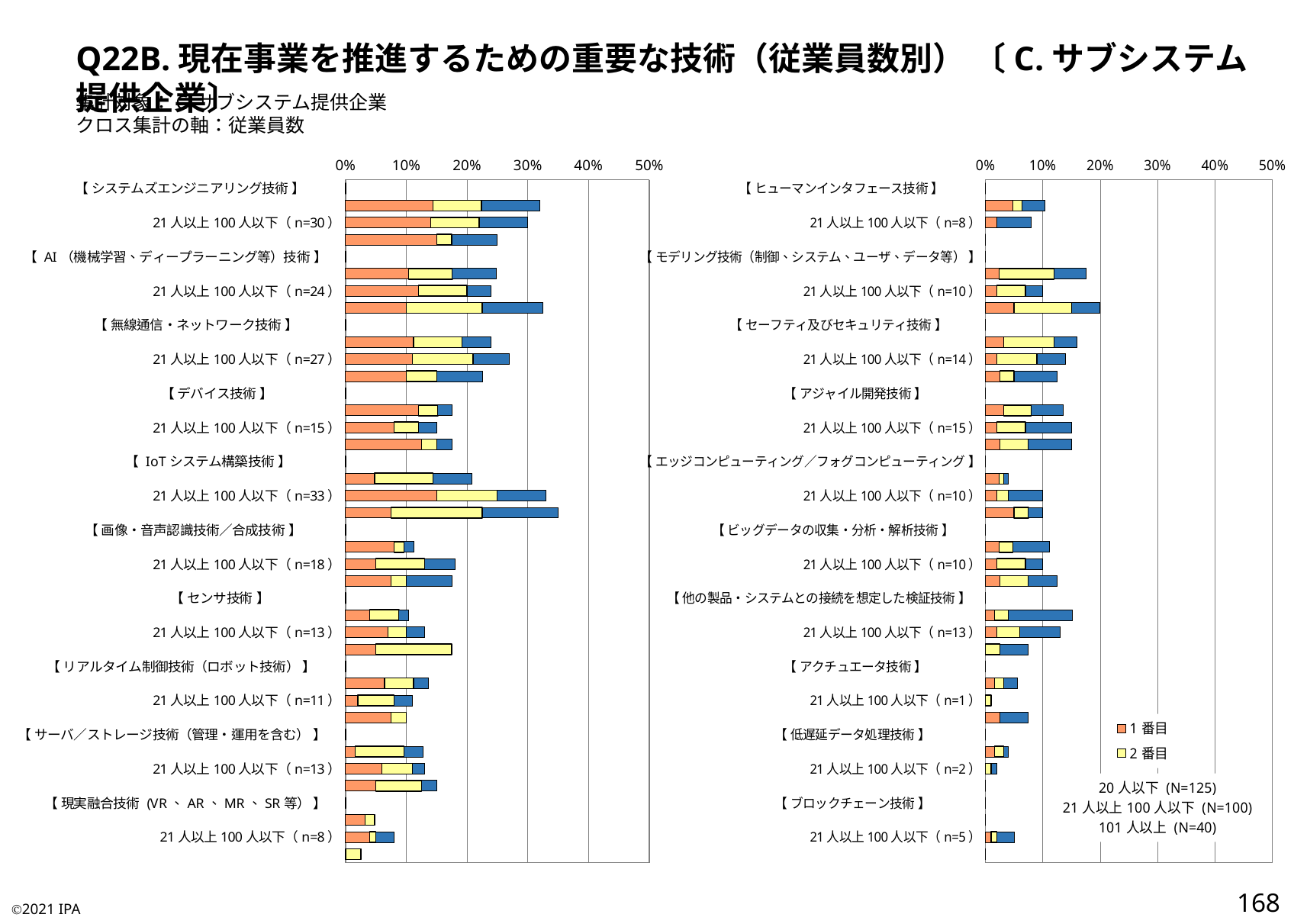
In the right chart, which technology group has the longest bar overall? 【モデリング技術（制御、システム、ユーザ、データ等）】 What is the maximum value shown on the horizontal axis of the right chart? 50% What kind of chart is the right chart on the slide? bar chart In the left chart, which technology group has the longest bar overall? 【IoTシステム構築技術】 In the left chart, which is larger: the 101人以上 bar under 【IoTシステム構築技術】 or the 101人以上 bar under 【現実融合技術（VR、AR、MR、SR等）】? 【IoTシステム構築技術】 What kind of chart is the left chart on the slide? bar chart How many technology groups are listed in the left chart? 10 In the right chart, is the value for the 20人以下 bar under 【他の製品・システムとの接続を想定した検証技術】 greater or less than 10%? greater In the left chart, is the value for the 101人以上 bar under 【IoTシステム構築技術】 greater or less than 30%? greater In the right chart, is the value for the 21人以上100人以下 bar under 【ブロックチェーン技術】 greater or less than 10%? less What are the two entries shown in the legend on the right chart? 1 番目, 2 番目